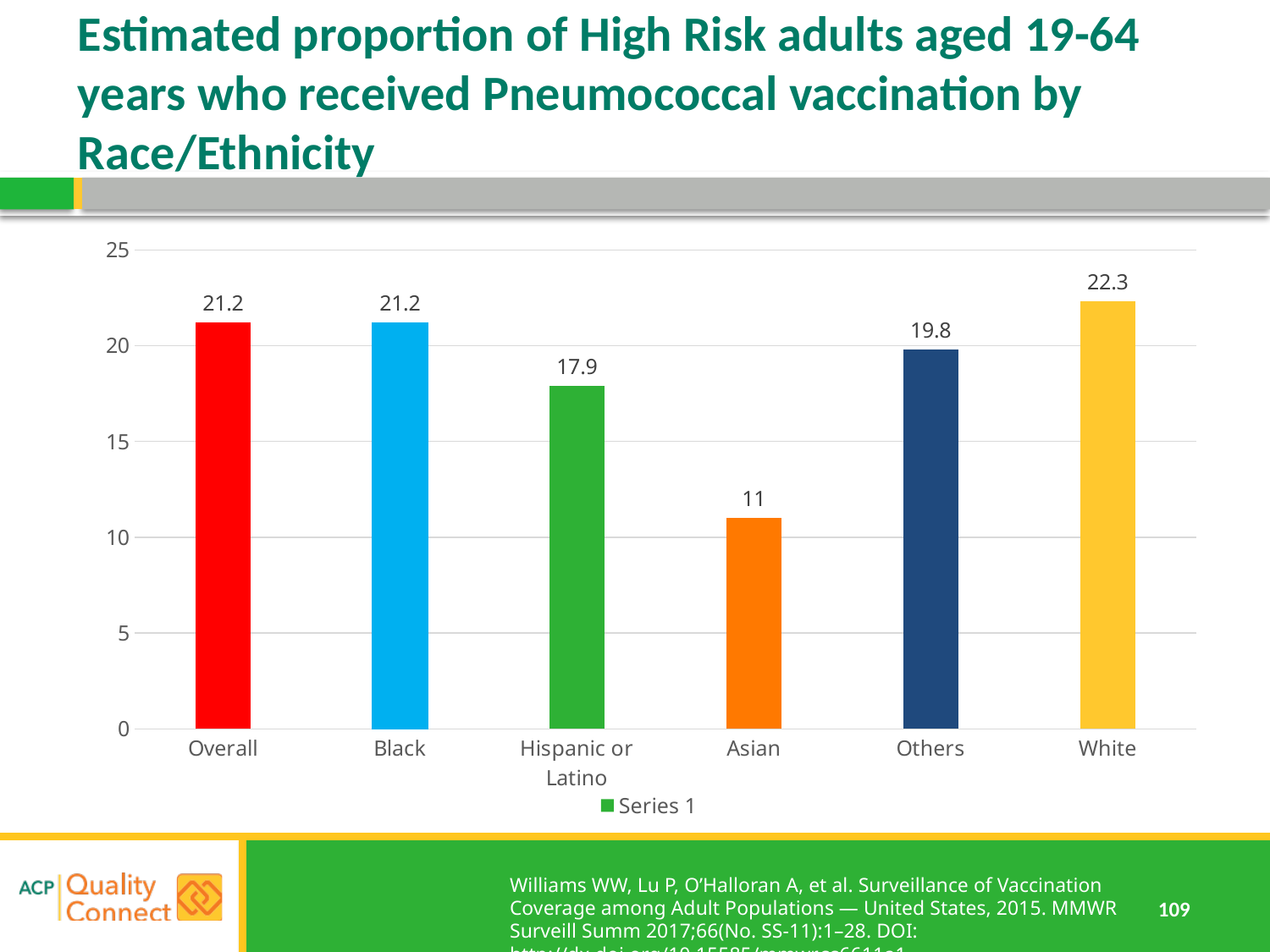
Which category has the lowest value? Asian What is the value for Others? 19.8 What is the value for White? 22.3 What kind of chart is shown on the slide? Bar chart Which category has the highest value? White What is the difference between the values for White and Asian? 11.3 Which is larger, the value for Others or the value for Hispanic or Latino? Others What is the value for Hispanic or Latino? 17.9 How many categories are shown on the x axis? 6 What series name does the legend show? Series 1 What is the difference between the values for Black and Hispanic or Latino? 3.3 What is the value for Asian? 11